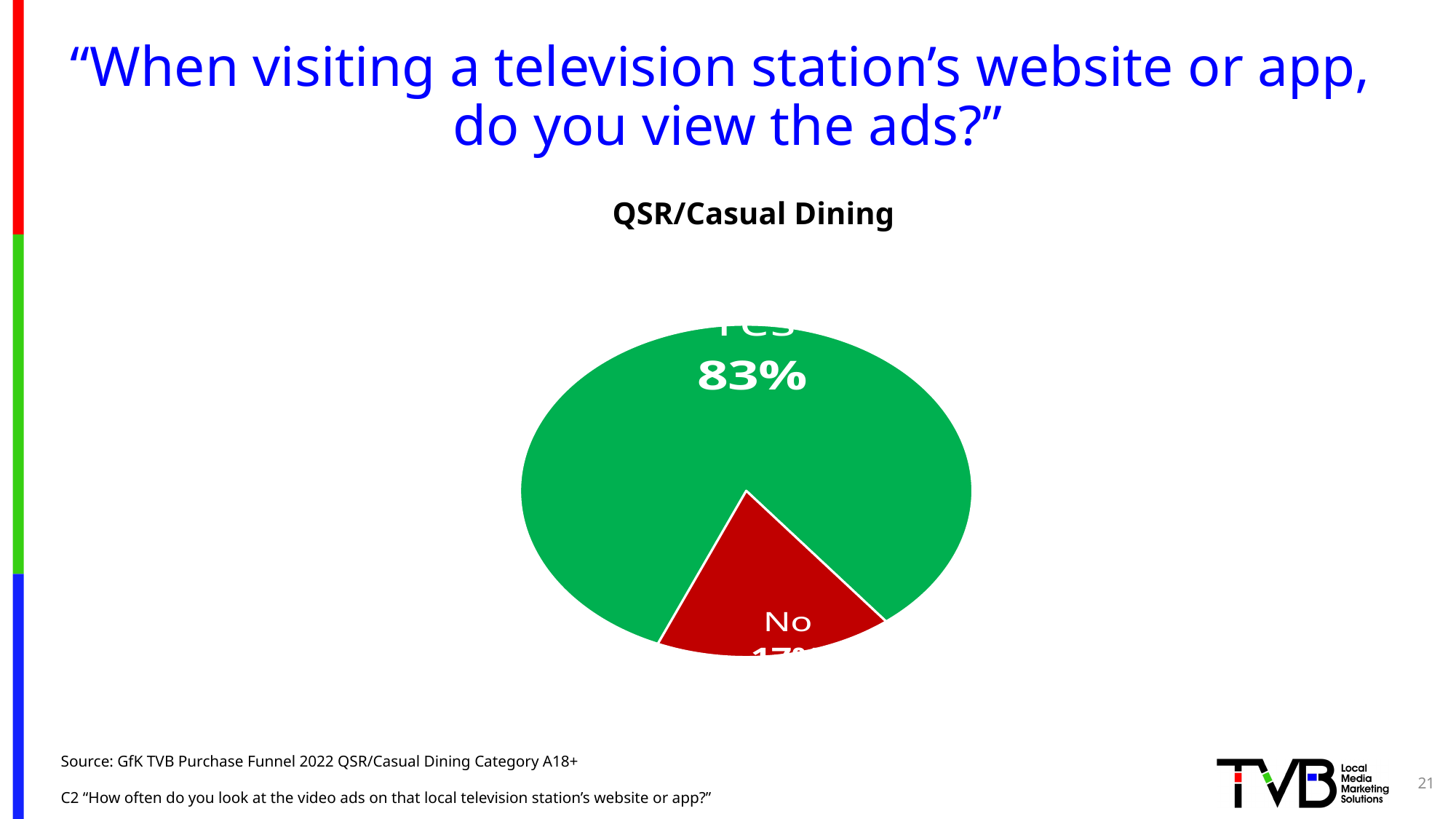
What share of the pie does the "Yes" slice represent? 83% What kind of chart is shown on the slide? Pie chart Which slice is larger, "Yes" or "No"? Yes What colour is the "No" slice of the pie chart? Red Which response has the smallest slice in the pie chart? No What percentage of respondents answered "Yes" in the QSR/Casual Dining pie chart? 83% How many slices does the pie chart have? 2 Is the share for "Yes" greater or less than 50%? greater Which response has the largest slice in the pie chart? Yes What is the title shown above the pie chart? QSR/Casual Dining